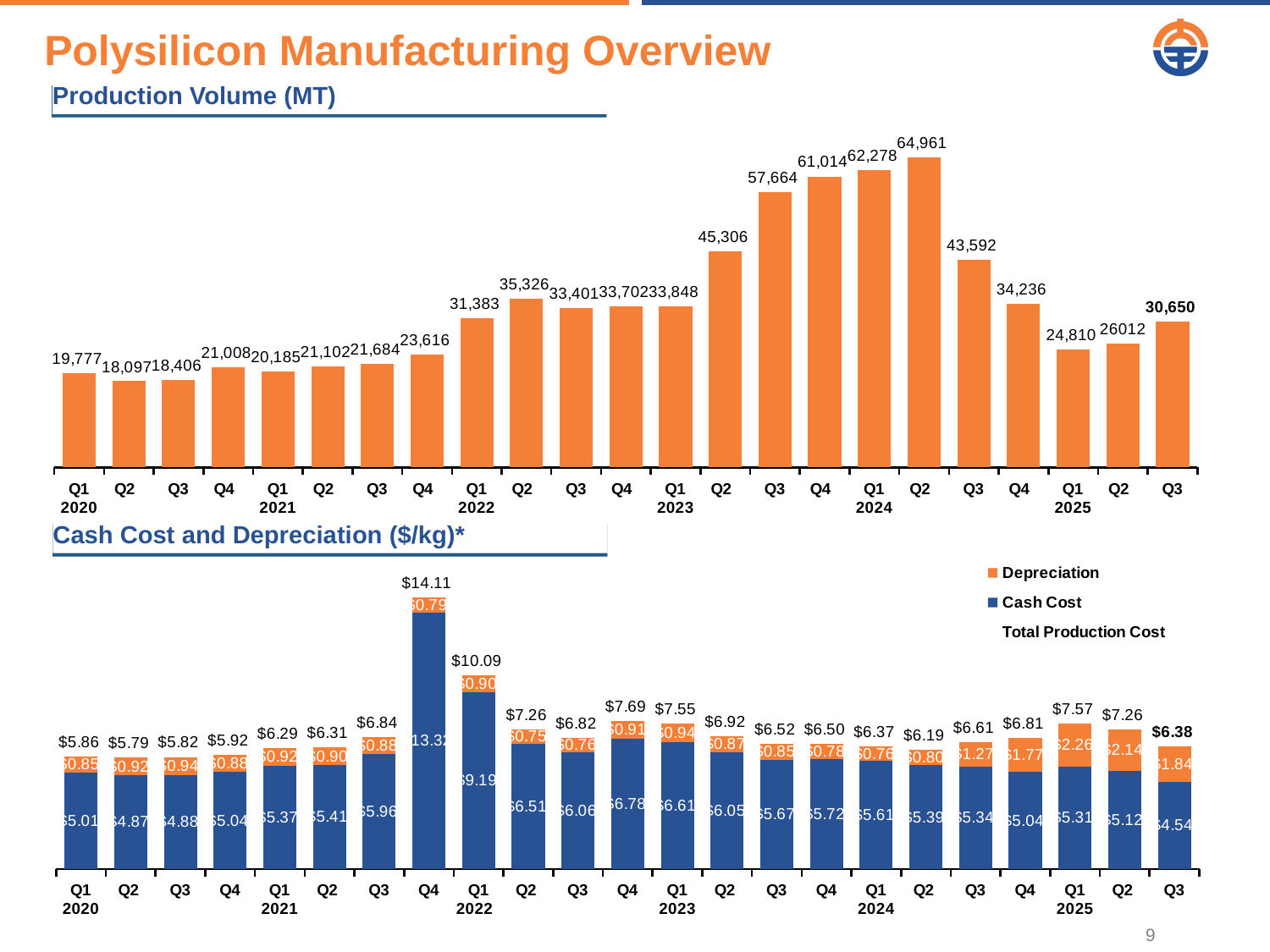
How many quarters are shown in the Production Volume (MT) chart? 23 In the Cash Cost and Depreciation ($/kg) chart, what was the depreciation in Q1 2025? $2.26 In the Production Volume (MT) chart, what is the difference in production volume between Q3 2025 and Q2 2025? 4,638 In the Production Volume (MT) chart, what was the production volume in Q2 2024? 64,961 What type of chart is the Cash Cost and Depreciation ($/kg) chart? Stacked bar chart In the Production Volume (MT) chart, which quarter had the lowest production volume? Q2 2020 In the Cash Cost and Depreciation ($/kg) chart, what was the cash cost in Q3 2025? $4.54 In the Cash Cost and Depreciation ($/kg) chart, what was the total production cost in Q4 2021? $14.11 In the Cash Cost and Depreciation ($/kg) chart, which quarter had the highest total production cost? Q4 2021 In the Production Volume (MT) chart, which quarter had the highest production volume? Q2 2024 In the Production Volume (MT) chart, what was the production volume in Q3 2025? 30,650 In the Production Volume (MT) chart, which quarter had higher production volume, Q3 2023 or Q3 2024? Q3 2023